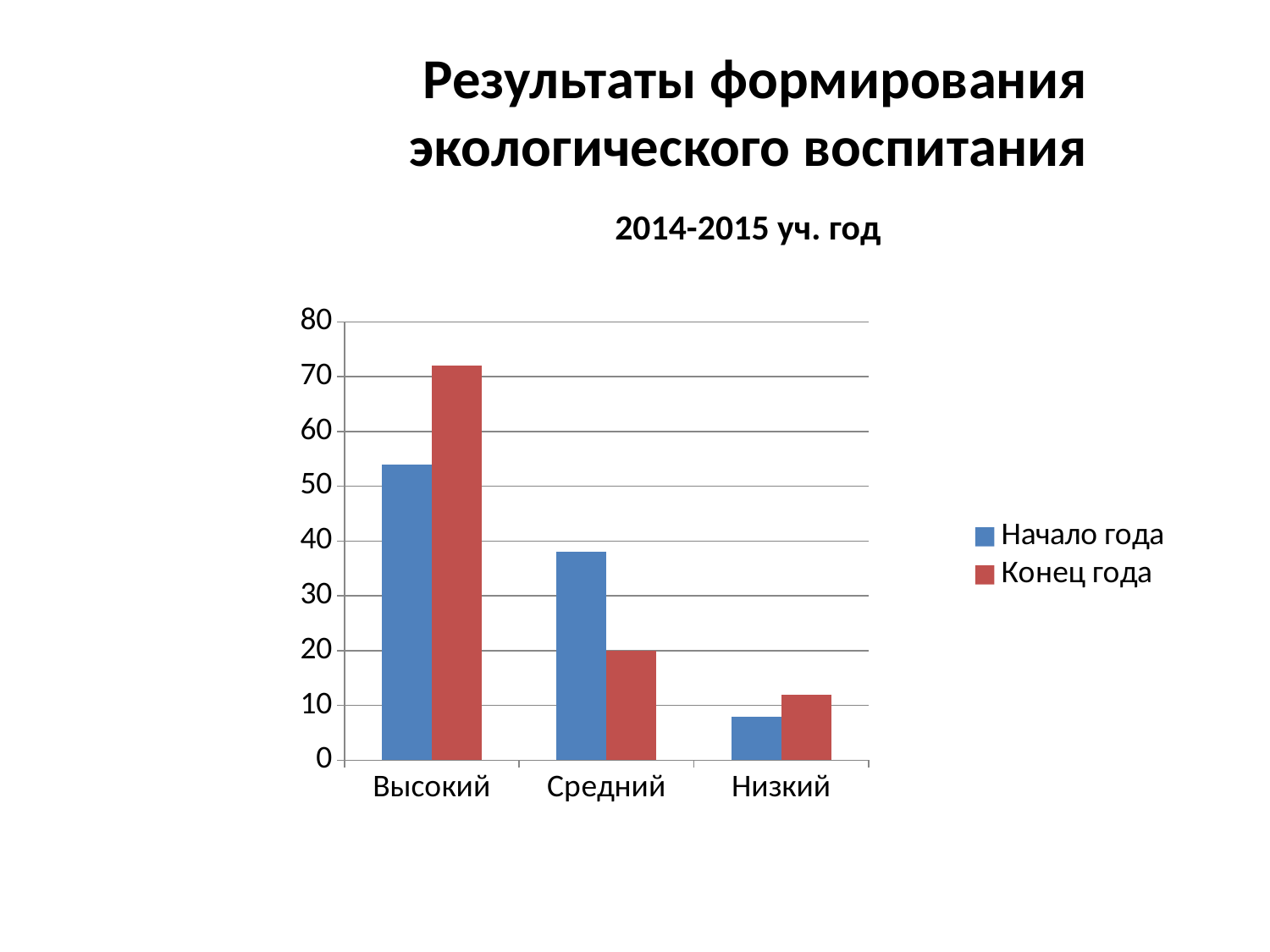
How many categories are shown on the x axis of the chart? 3 For Высокий, which series has the larger value: Начало года or Конец года? Конец года Is the value for Средний in the Начало года series greater or less than 40? less What type of chart is shown on the slide? Bar chart What is the title shown directly above the chart? 2014-2015 уч. год Which category has the shortest bar in the Начало года series? Низкий For Средний, which series has the larger value: Начало года or Конец года? Начало года Which category has the tallest bar in the Конец года series? Высокий What is the value for Средний in the Конец года series? 20 Is the value for Высокий in the Конец года series greater or less than 70? greater Is the value for Низкий in the Начало года series greater or less than 10? less How many series does the chart legend list? 2